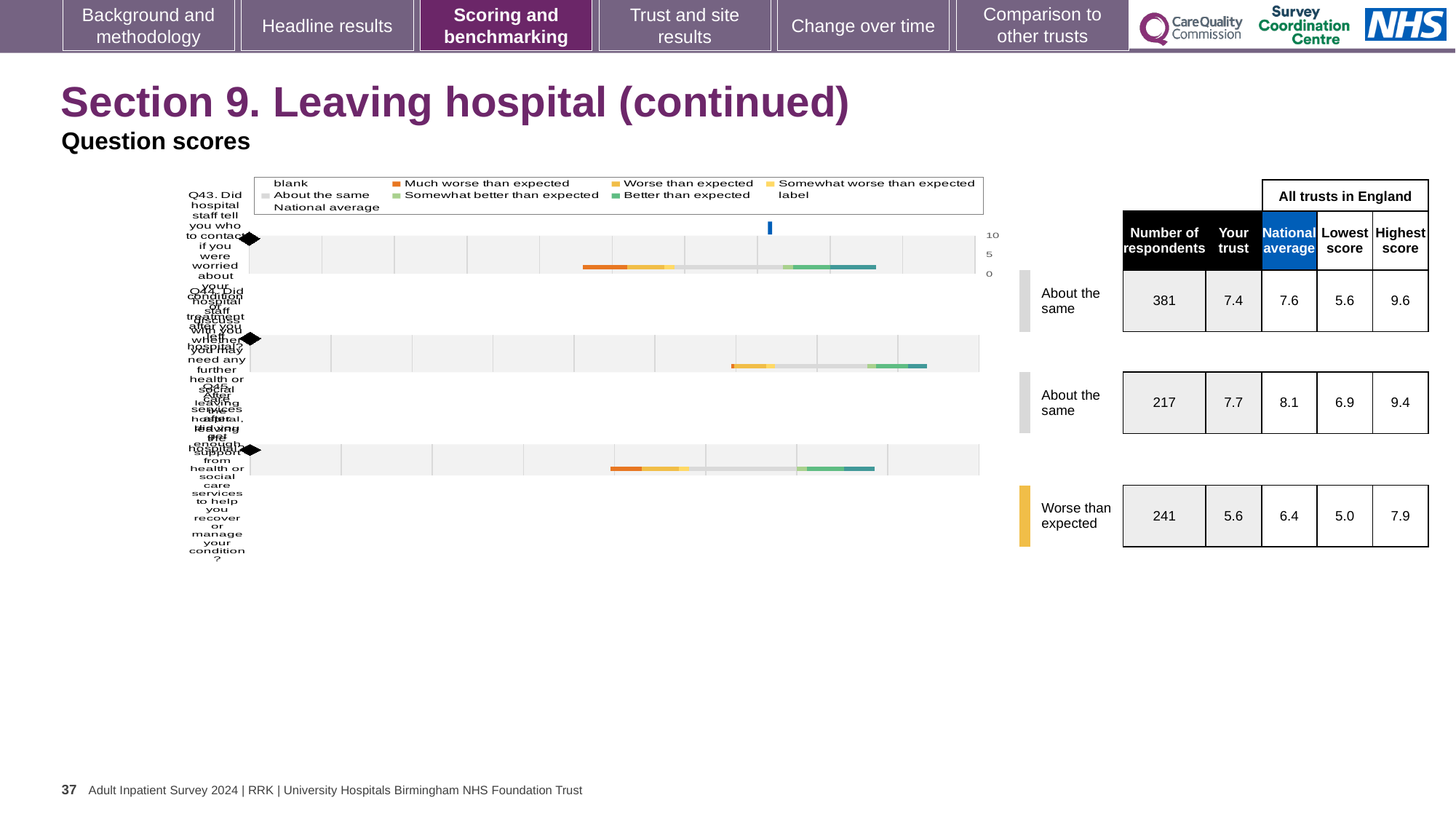
What is the 'Your trust' score for the first question row (Q43)? 7.4 What is the number of respondents for the second question row? 217 What kind of chart is shown on the slide? bar chart Which question row has the highest number of respondents? the first row (Q43), 381 What is the 'Your trust' score for the third question row, rated 'Worse than expected'? 5.6 Is the trust score for the second question row larger or smaller than its national average? smaller What is the highest score among all trusts in England for the second question row? 9.4 How many question rows (bars) are plotted in the chart? 3 What is the national average for the first question row (Q43)? 7.6 Which benchmark rating is shown for the third question row? Worse than expected What is the lowest score among all trusts in England for the third question row? 5.0 What is the difference between the national average and the trust score for the third question row? 0.8